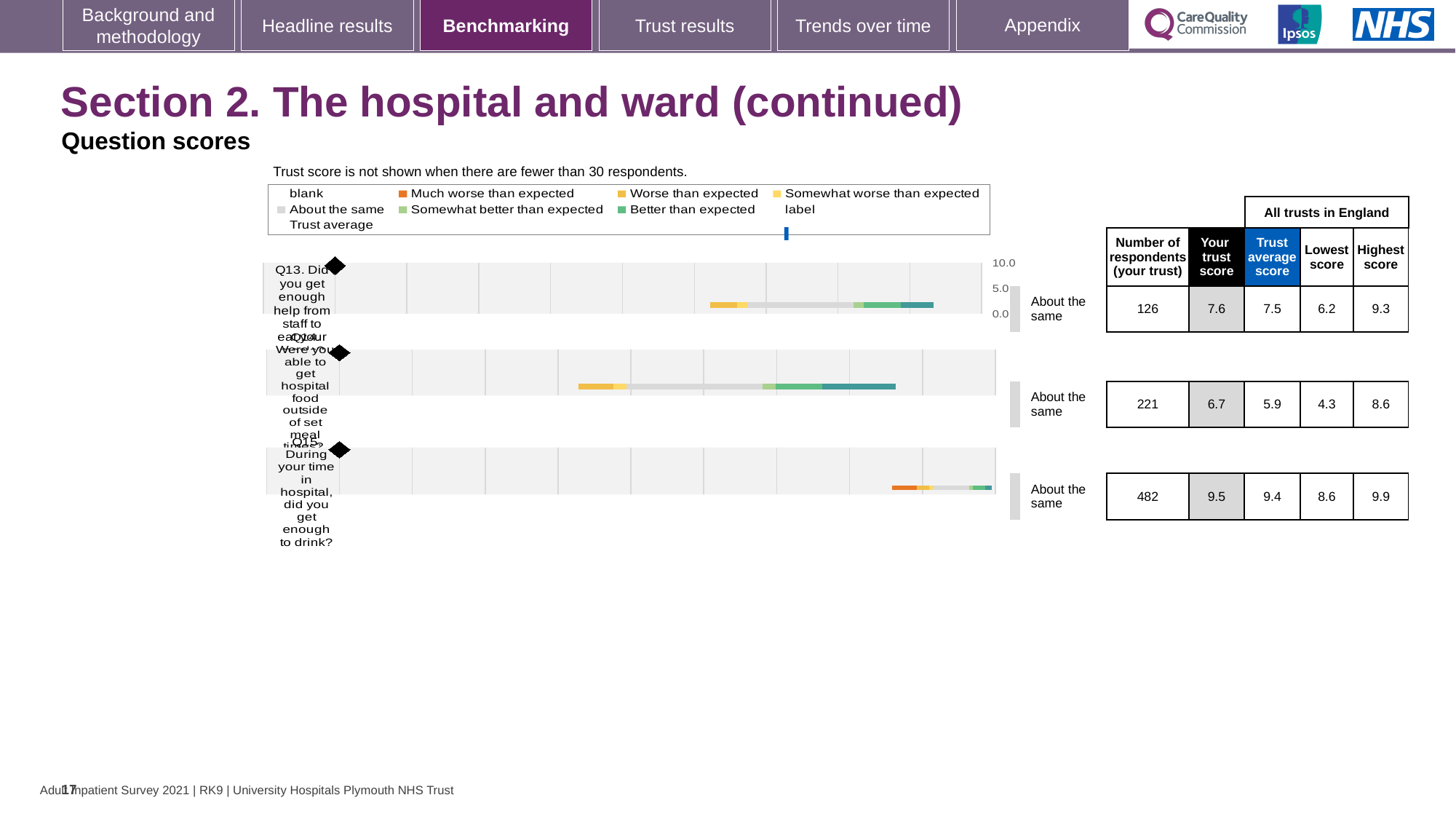
What is the lowest score across all trusts in England for Q13? 6.2 What kind of chart is used to show the question scores? Bar chart Which question has the highest 'Your trust score'? Q15 What is the trust average score for Q14 (Were you able to get hospital food outside of set meal times)? 5.9 Which has the larger 'Your trust score', Q13 or Q14? Q13 What is the difference between the 'Your trust score' and the trust average score for Q14? 0.8 What is the highest score across all trusts in England for Q15? 9.9 How many questions are plotted on the slide? 3 What benchmark category is shown for Q14? About the same Which question has the fewest respondents? Q13 What is the 'Your trust score' value for Q13 (Did you get enough help from staff to eat your meals)? 7.6 How many respondents are shown for Q15 (During your time in hospital, did you get enough to drink)? 482